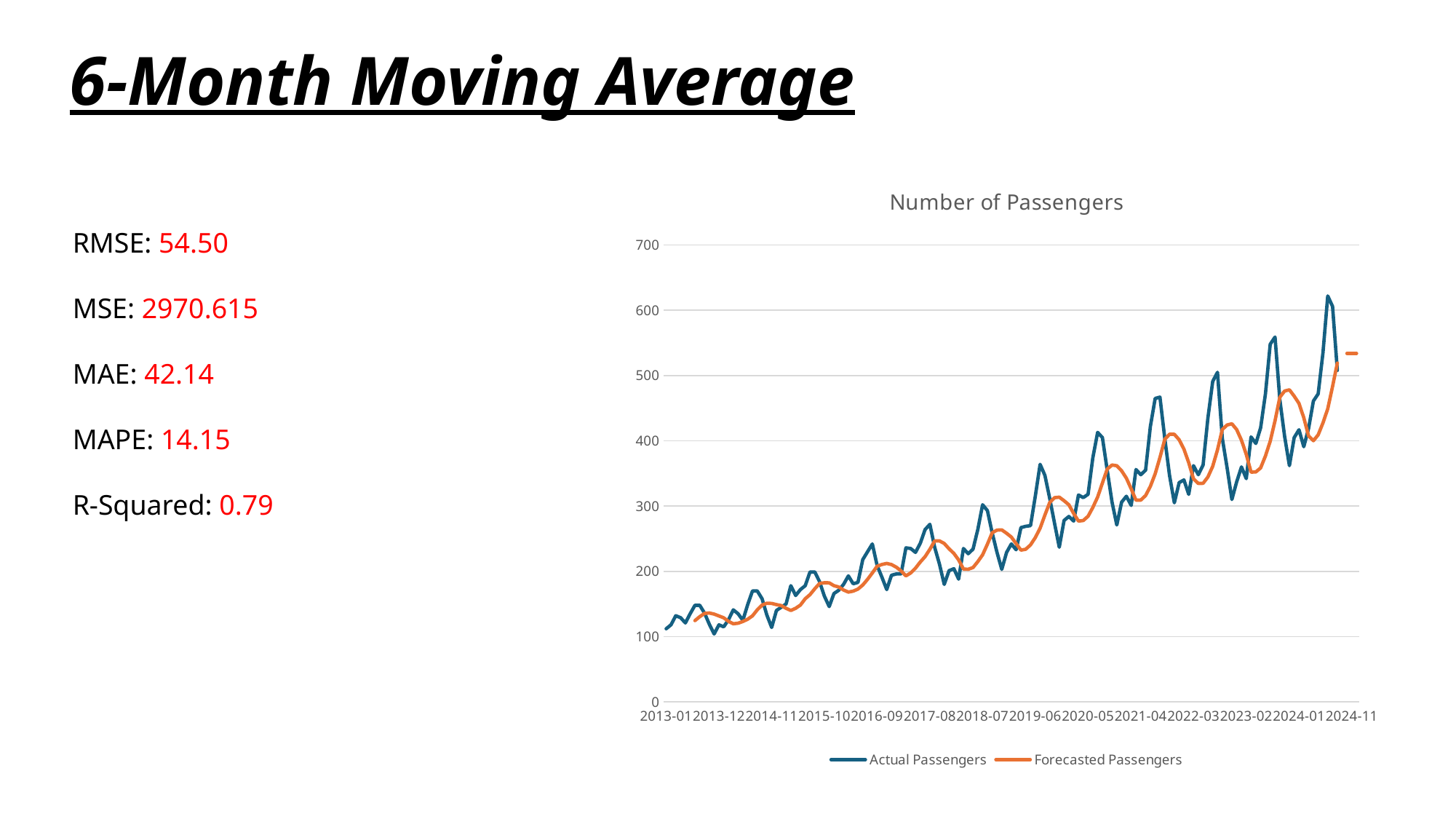
How many date labels are shown along the x axis of the chart? 14 Is the value of Forecasted Passengers at 2024-11 greater or less than 400? greater Is the peak value of the Actual Passengers series greater or less than 500? greater What is the title of the chart on the slide? Number of Passengers Which series has the higher peak value, Actual Passengers or Forecasted Passengers? Actual Passengers What kind of chart is shown on the slide? Line chart Is the value of Actual Passengers at 2013-01 greater or less than 200? less Which series in the chart is drawn in orange? Forecasted Passengers Which series reaches the highest value on the chart? Actual Passengers How many series does the legend of the Number of Passengers chart list? 2 Do the Actual Passengers values generally rise or fall from 2013-01 to 2024-11? Rise